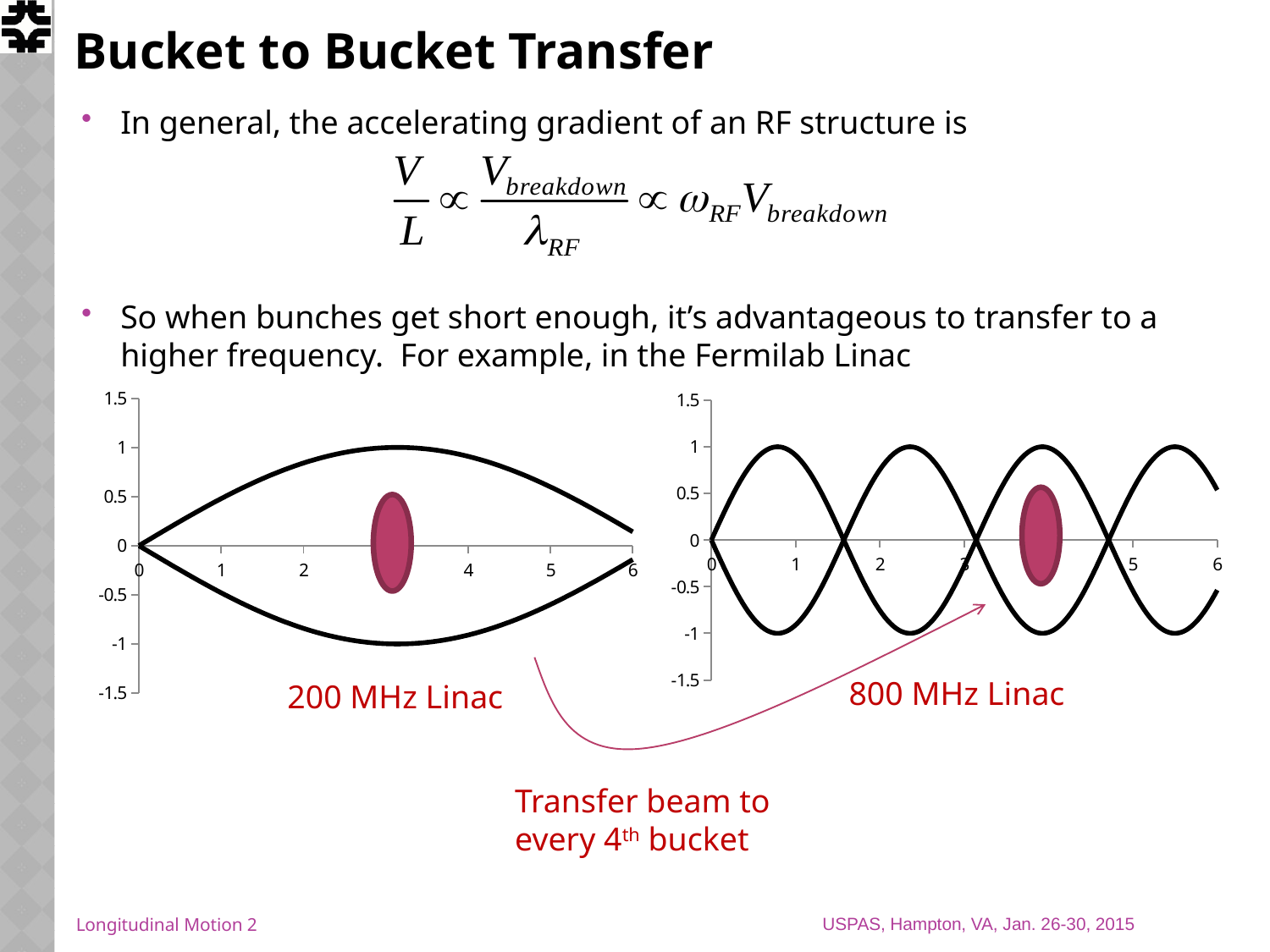
In the 800 MHz Linac chart on the right, is the value of the upper curve at x = 3 greater or less than 0.5? less In the 800 MHz Linac chart on the right, what is the minimum value reached by the lower curve? -1 In the 800 MHz Linac chart on the right, how many complete buckets (lobes) are drawn between x = 0 and x = 6? 3 In the 200 MHz Linac chart on the left, how many buckets (lobes) are drawn between x = 0 and x = 6? 1 Which chart shows more buckets across the x-axis range, the 200 MHz Linac chart or the 800 MHz Linac chart? 800 MHz Linac What is the highest tick value shown on the y-axis of the 200 MHz Linac chart? 1.5 How many charts are shown on the slide? 2 What kind of chart is the 200 MHz Linac chart on the left? line chart In the 200 MHz Linac chart on the left, is the value of the upper curve at x = 3 greater or less than 0.5? greater In the 200 MHz Linac chart on the left, what is the maximum value reached by the upper curve? 1 Which chart is labeled "800 MHz Linac", the left one or the right one? the right one